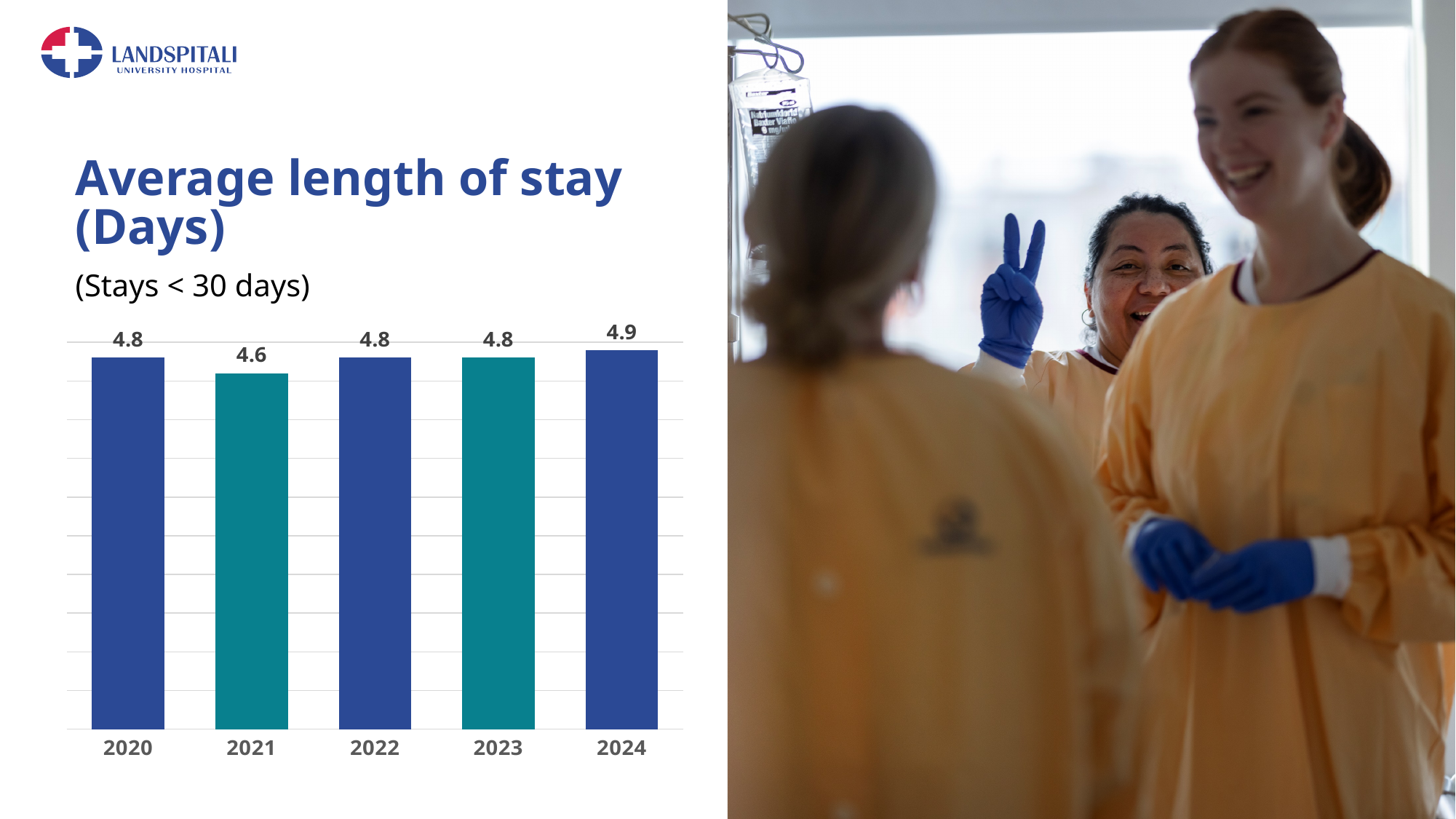
Which year has a larger average length of stay, 2021 or 2022? 2022 What is the difference between the average length of stay in 2024 and in 2021? 0.3 What is the title of the chart? Average length of stay (Days) What kind of chart is shown on the slide? Bar chart Which year has the lowest average length of stay? 2021 How many years are shown in the chart? 5 What is the average length of stay in 2024? 4.9 Which year has the highest average length of stay? 2024 What is the average length of stay in 2020? 4.8 What subtitle appears below the chart title? (Stays < 30 days) What is the average length of stay in 2021? 4.6 Did the average length of stay rise or fall from 2020 to 2021? Fall